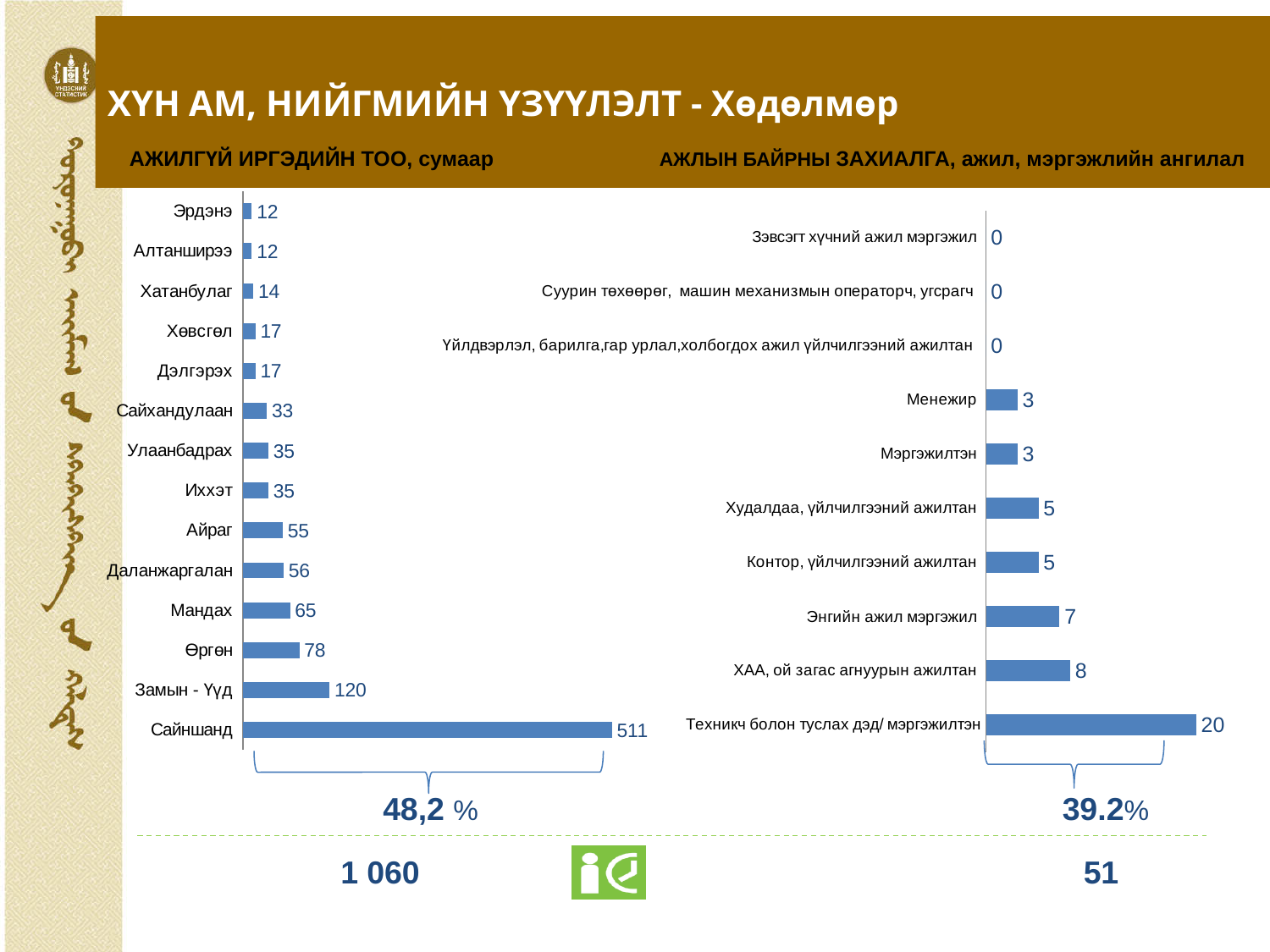
In the chart 'АЖИЛГҮЙ ИРГЭДИЙН ТОО, сумаар', what is the difference between Сайншанд and Замын - Үүд? 391 How many categories are shown in the chart 'АЖЛЫН БАЙРНЫ ЗАХИАЛГА, ажил, мэргэжлийн ангилал'? 10 In the chart 'АЖЛЫН БАЙРНЫ ЗАХИАЛГА, ажил, мэргэжлийн ангилал', what is the difference between Техникч болон туслах дэд/ мэргэжилтэн and Энгийн ажил мэргэжил? 13 How many categories are shown in the chart 'АЖИЛГҮЙ ИРГЭДИЙН ТОО, сумаар'? 14 In the chart 'АЖЛЫН БАЙРНЫ ЗАХИАЛГА, ажил, мэргэжлийн ангилал', what is the value for Техникч болон туслах дэд/ мэргэжилтэн? 20 In the chart 'АЖЛЫН БАЙРНЫ ЗАХИАЛГА, ажил, мэргэжлийн ангилал', how many categories have a value of 0? 3 In the chart 'АЖИЛГҮЙ ИРГЭДИЙН ТОО, сумаар', which is larger, Өргөн or Мандах? Өргөн In the chart 'АЖИЛГҮЙ ИРГЭДИЙН ТОО, сумаар', what is the value for Даланжаргалан? 56 What kind of chart is 'АЖИЛГҮЙ ИРГЭДИЙН ТОО, сумаар'? Bar chart In the chart 'АЖЛЫН БАЙРНЫ ЗАХИАЛГА, ажил, мэргэжлийн ангилал', what is the value for ХАА, ой загас агнуурын ажилтан? 8 In the chart 'АЖИЛГҮЙ ИРГЭДИЙН ТОО, сумаар', which category has the highest value? Сайншанд In the chart 'АЖИЛГҮЙ ИРГЭДИЙН ТОО, сумаар', what is the value for Замын - Үүд? 120